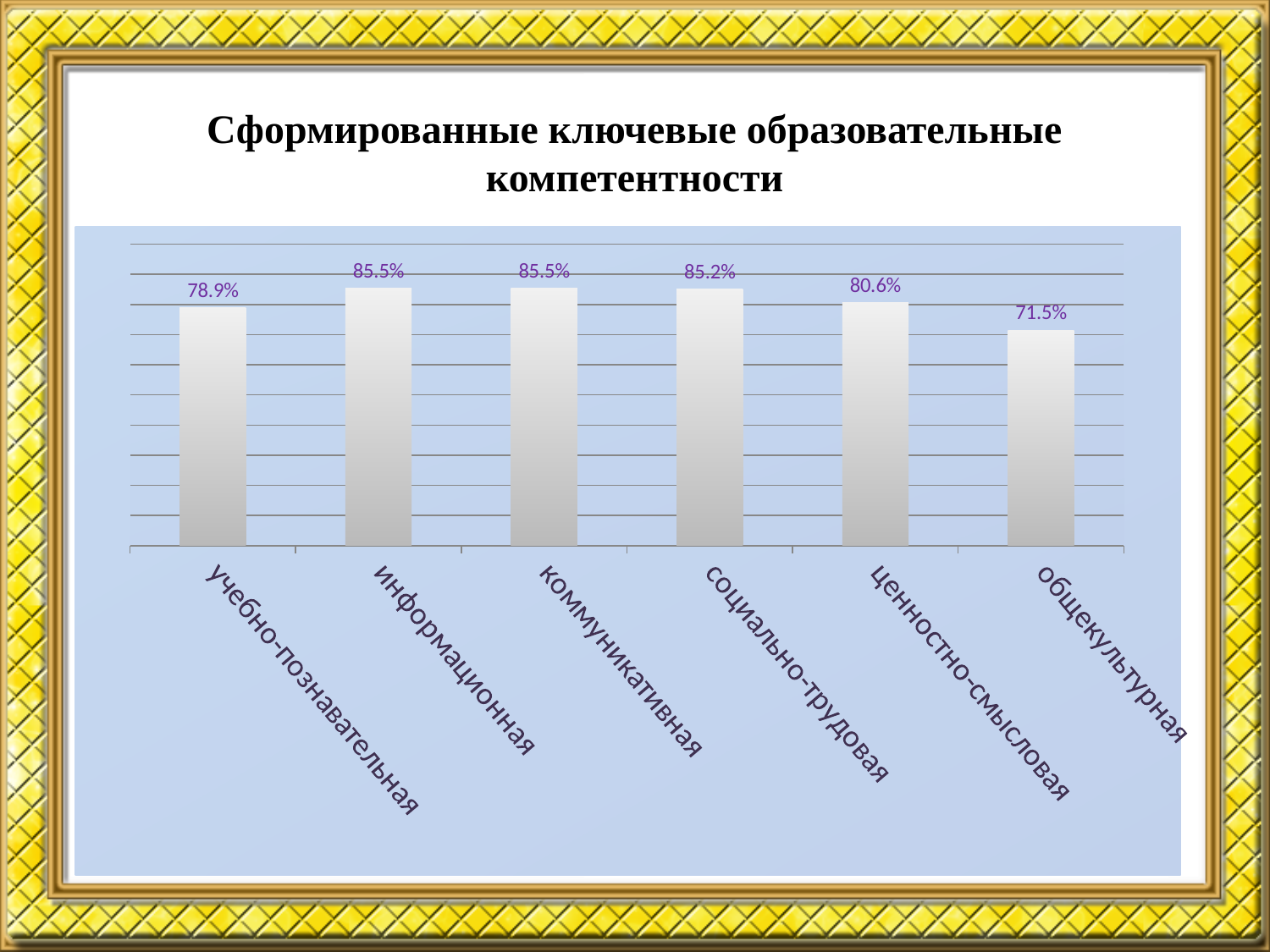
What is the difference between the values for коммуникативная and учебно-познавательная? 6.6% What is the value for общекультурная? 71.5% Which is larger, the value for учебно-познавательная or the value for ценностно-смысловая? ценностно-смысловая What is the title of the slide? Сформированные ключевые образовательные компетентности How many categories are shown in the chart? 6 What kind of chart is shown on the slide? bar chart What is the value for социально-трудовая? 85.2% What is the value for ценностно-смысловая? 80.6% What is the value for учебно-познавательная? 78.9% What is the value for информационная? 85.5% What is the difference between the values for ценностно-смысловая and общекультурная? 9.1% Which category has the lowest value? общекультурная